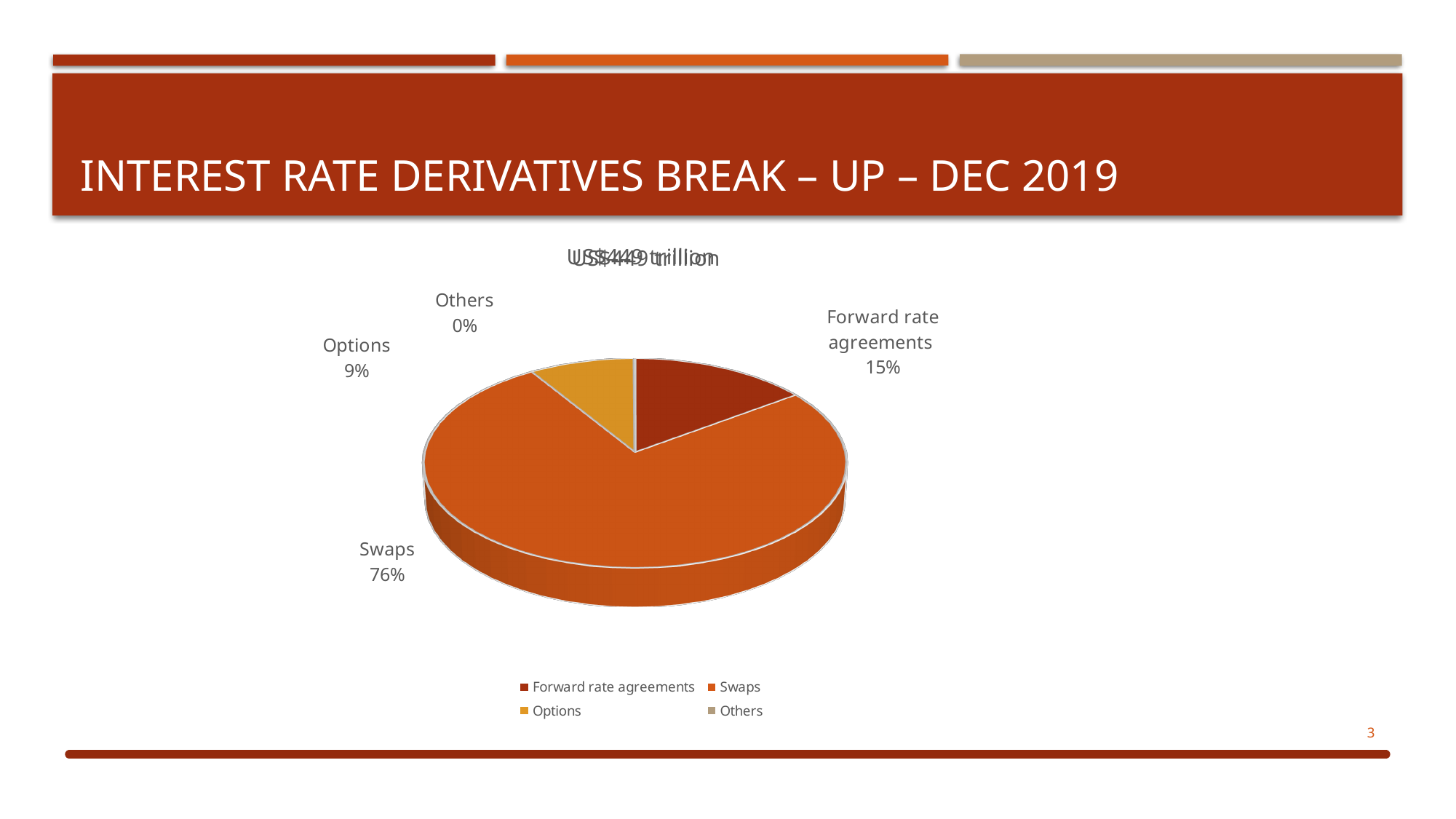
Which is larger, the share for Options or the share for Forward rate agreements? Forward rate agreements What share of the pie does Options account for? 9% Which category has the largest slice of the pie? Swaps Which category has the smallest slice of the pie? Others What is the difference in percentage points between Forward rate agreements and Options? 6 What is the difference in percentage points between Swaps and Forward rate agreements? 61 What colour is the Options slice in the pie chart? Gold/yellow-orange What percentage is shown for Others? 0% What share of the pie does Forward rate agreements account for? 15% What share of the pie does Swaps account for? 76% How many categories does the legend list? 4 What kind of chart is shown on the slide? Pie chart